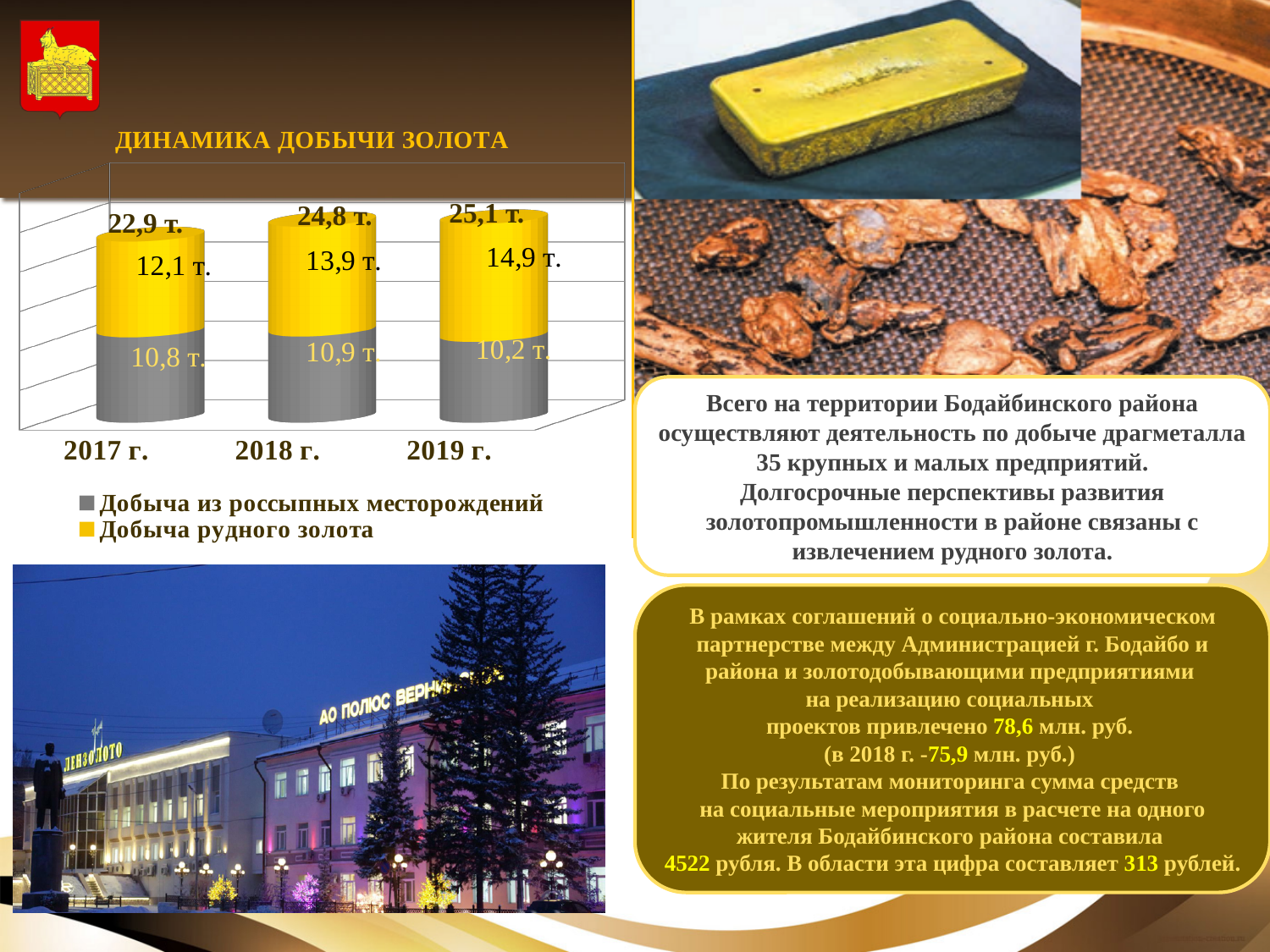
Which year has the highest total gold production? 2019 г. What is the total gold production shown for 2017 г.? 22,9 т. What is the title of the chart? ДИНАМИКА ДОБЫЧИ ЗОЛОТА What is the value of 'Добыча рудного золота' for 2019 г.? 14,9 т. Which year has the lowest value for 'Добыча из россыпных месторождений'? 2019 г. In 2018 г., which is larger: 'Добыча рудного золота' or 'Добыча из россыпных месторождений'? Добыча рудного золота How many series does the chart legend list? 2 What is the difference between 'Добыча рудного золота' in 2019 г. and 2017 г.? 2,8 т. Does the total gold production rise or fall from 2017 г. to 2019 г.? rise How many years (categories) are shown on the chart? 3 What kind of chart is shown on the slide? stacked bar chart What is the value of 'Добыча из россыпных месторождений' for 2018 г.? 10,9 т.